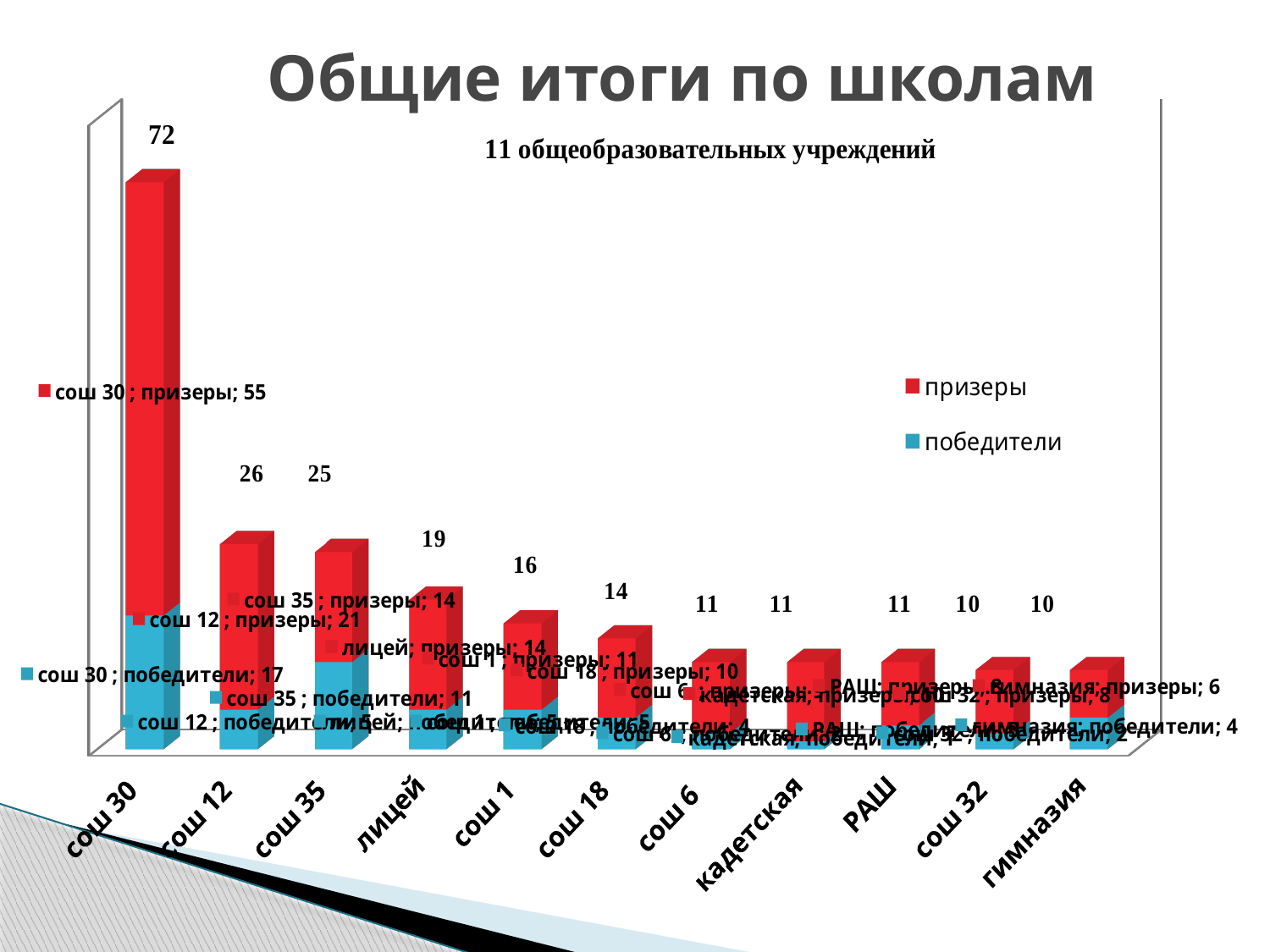
Which is larger, the total for лицей or the total for сош 1? лицей How many победители does сош 30 have according to the data label? 17 What kind of chart is shown on the slide? stacked bar chart How many победители does сош 35 have according to the data label? 11 How many series does the legend list? 2 What is the difference between the total for сош 30 and the total for сош 12? 46 What is the total value shown above the bar for сош 12? 26 How many призеры does сош 12 have according to the data label? 21 How many schools (categories) are shown on the x axis? 11 Which school has the highest total bar? сош 30 How many призеры does сош 30 have according to the data label? 55 What is the total value shown above the bar for сош 30? 72